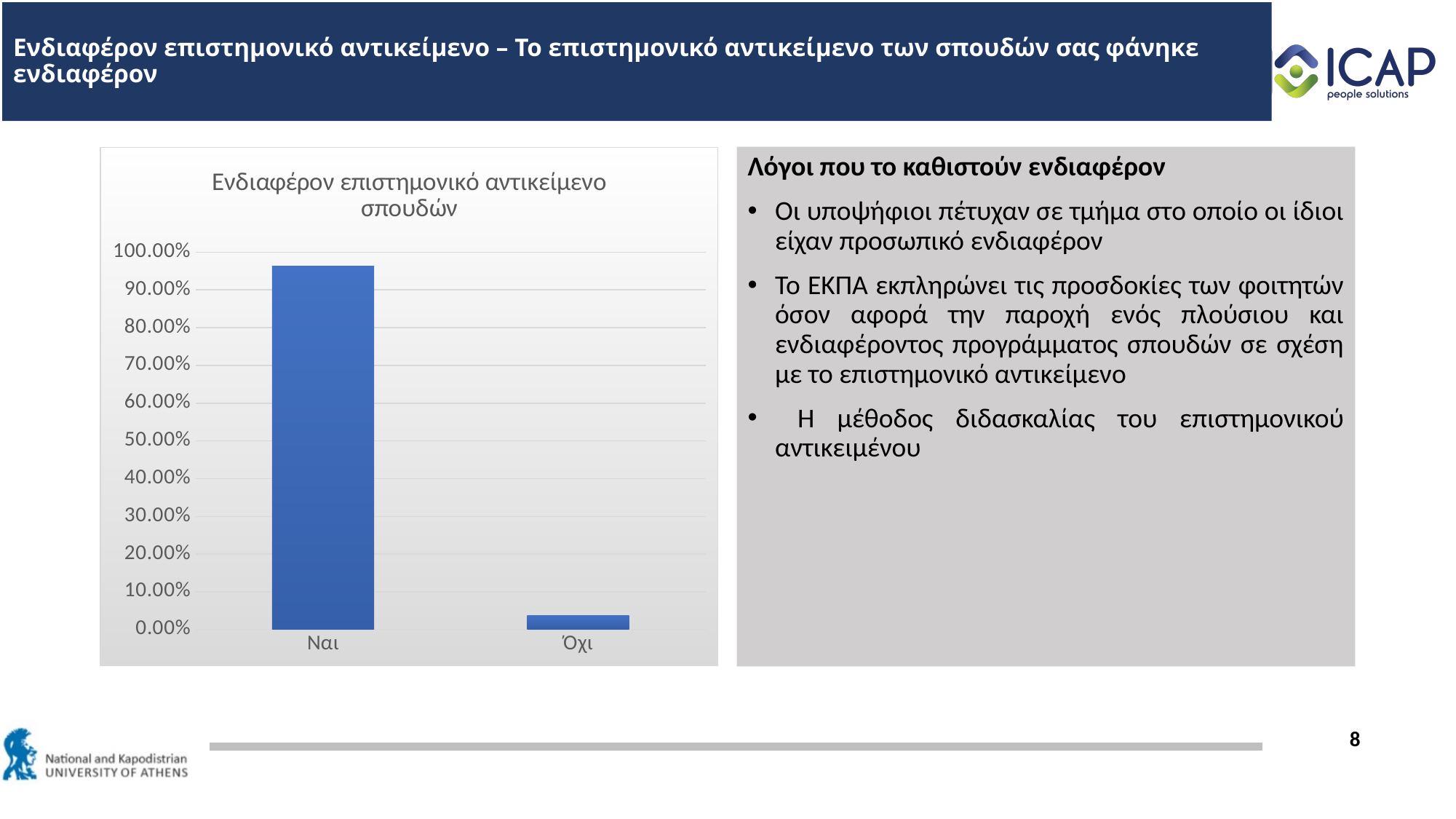
Is the value for Όχι greater or less than 20.00%? less What is the highest tick value shown on the y axis of the chart? 100.00% Is the value for Ναι greater or less than 90.00%? greater What is the title of the chart? Ενδιαφέρον επιστημονικό αντικείμενο σπουδών Which category has the highest value in the chart? Ναι Which is larger, the value for Ναι or the value for Όχι? Ναι Is the value for Ναι greater or less than 50.00%? greater Which category has the lowest value in the chart? Όχι What kind of chart is shown on the slide? bar chart How many categories are shown on the x axis of the chart? 2